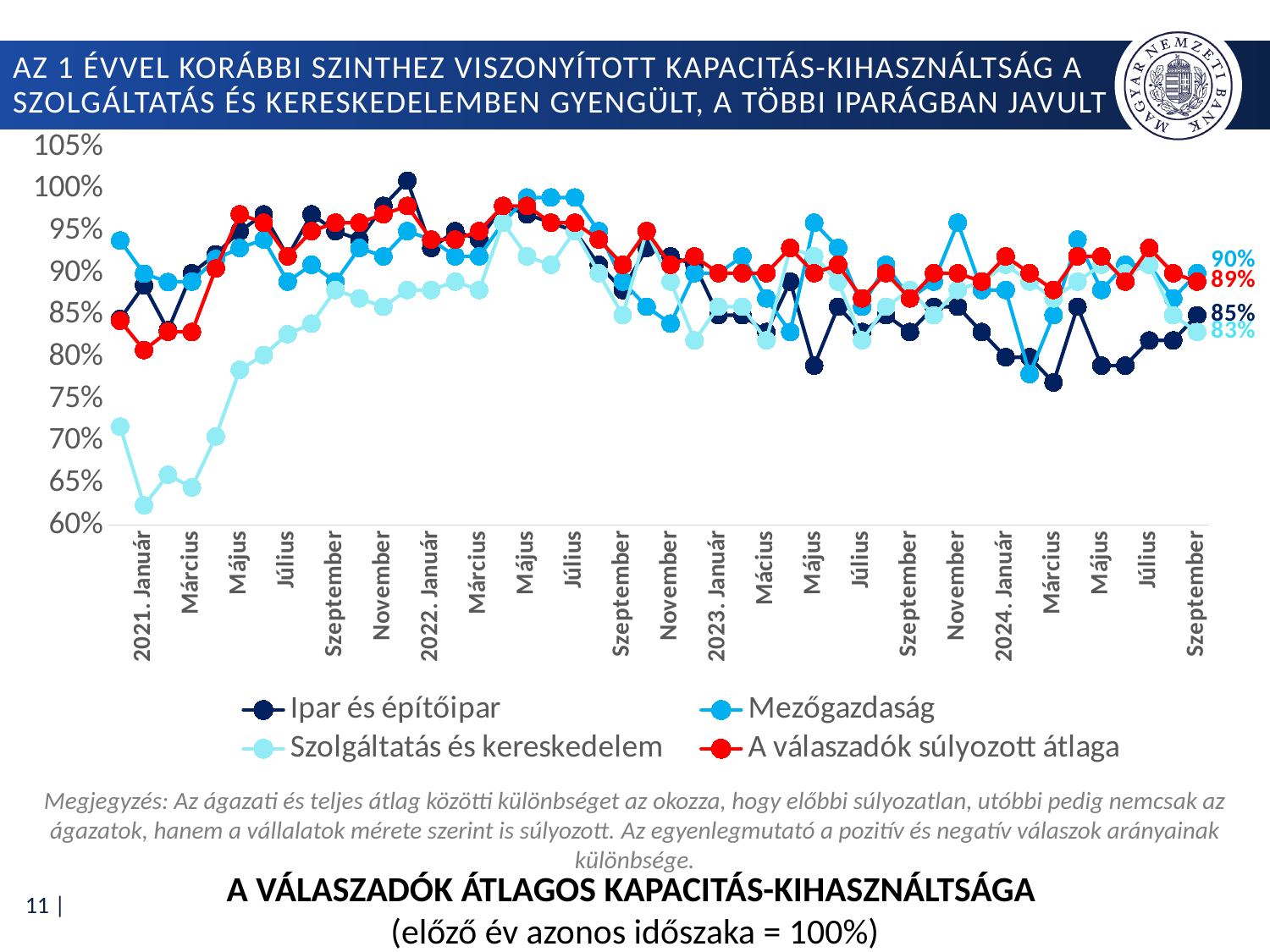
How many series does the legend list? 4 What kind of chart is shown on the slide? line chart What is the title of the chart? A válaszadók átlagos kapacitás-kihasználtsága (előző év azonos időszaka = 100%) Is the value for Szolgáltatás és kereskedelem in 2021. Január greater or less than 75%? less What is the value for Mezőgazdaság at the end of the series (September 2024)? 90% What is the value for Szolgáltatás és kereskedelem at the end of the series (September 2024)? 83% Which series has the highest value at the end of the series (September 2024)? Mezőgazdaság At the end of the series, which is larger: Ipar és építőipar or Szolgáltatás és kereskedelem? Ipar és építőipar What is the difference between the final values of Mezőgazdaság and Szolgáltatás és kereskedelem? 7 percentage points Which series has the lowest value at the end of the series (September 2024)? Szolgáltatás és kereskedelem What is the value for Ipar és építőipar at the end of the series (September 2024)? 85% What is the value for A válaszadók súlyozott átlaga at the end of the series (September 2024)? 89%